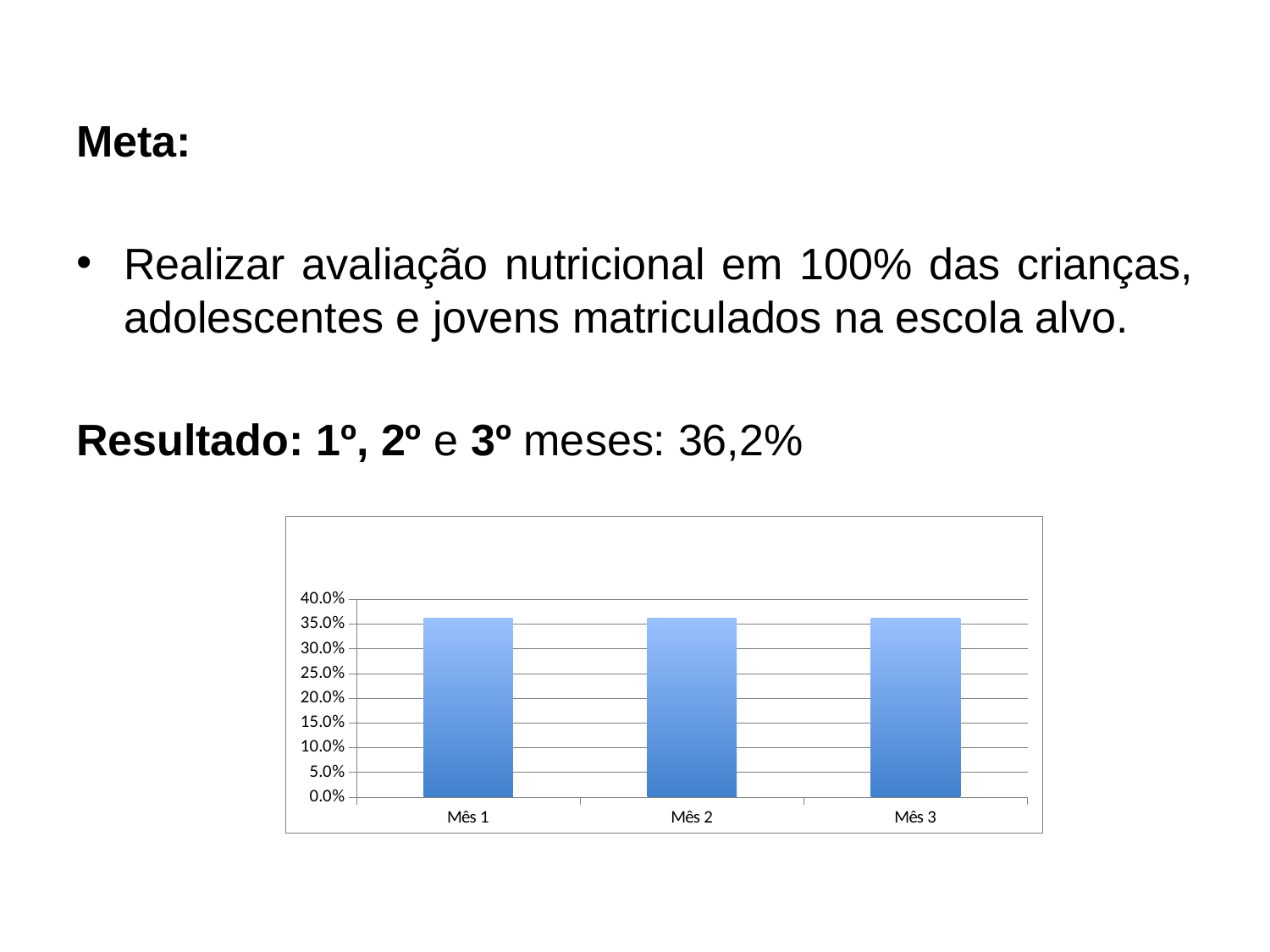
What are the category labels on the x axis of the chart? Mês 1, Mês 2, Mês 3 Is the value for Mês 2 greater or less than 35.0%? greater According to the slide text, what value was reached in the 1st, 2nd and 3rd months? 36,2% What kind of chart is shown on the slide? bar chart What is the highest value shown on the chart's y axis? 40.0% Is the value for Mês 1 greater or less than 40.0%? less Is the value for Mês 3 greater or less than 30.0%? greater Do the values rise, fall, or stay flat from Mês 1 to Mês 3? stay flat How many categories (bars) does the chart show? 3